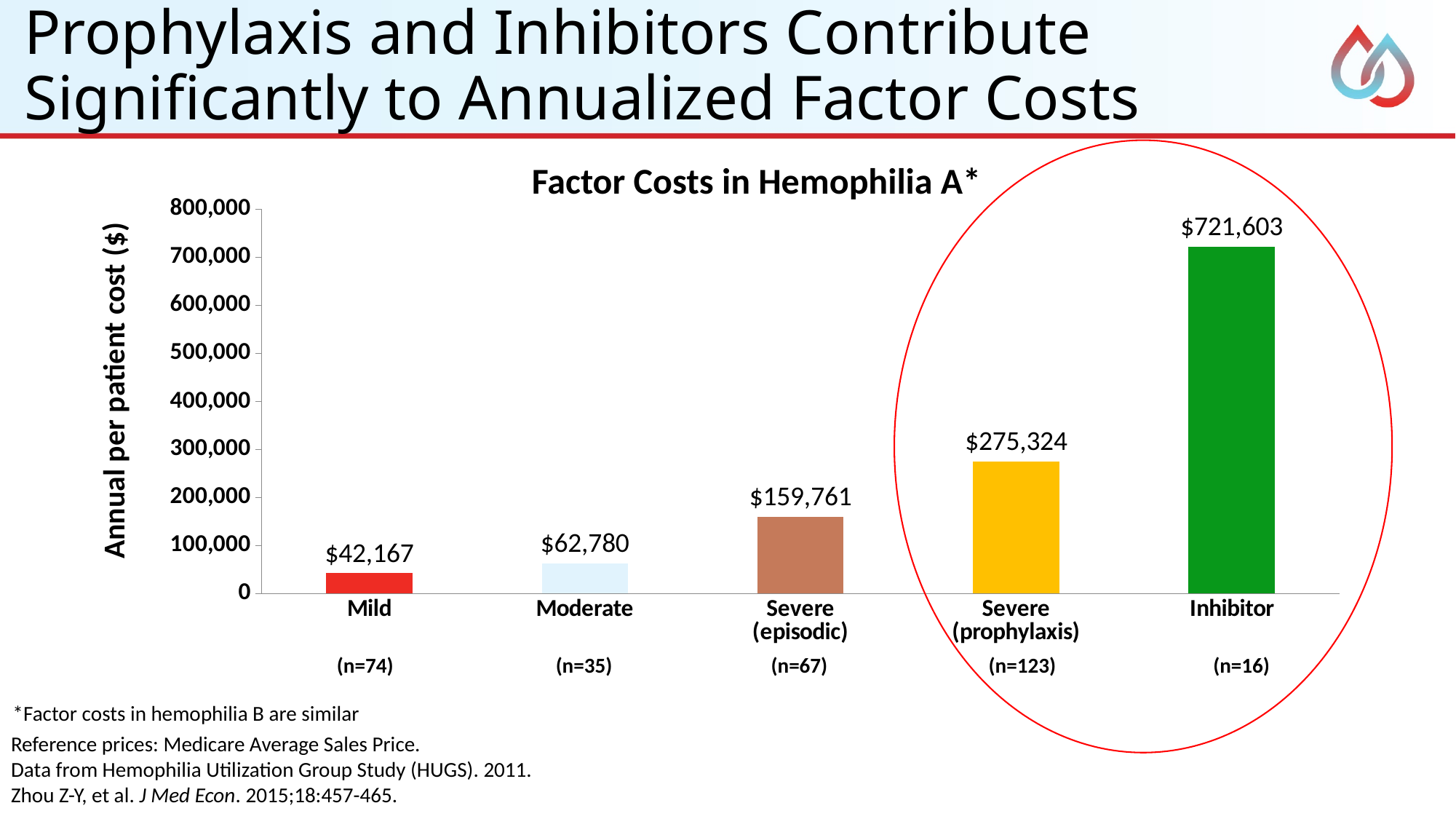
What is the annual per patient factor cost for Severe (prophylaxis)? $275,324 What type of chart is used to show factor costs in hemophilia A? Bar chart What is the annual per patient factor cost for the Inhibitor category? $721,603 What is the difference in annual per patient cost between Severe (prophylaxis) and Severe (episodic)? $115,563 Is the annual per patient cost for Inhibitor greater or less than 700,000? greater What is the title of the chart? Factor Costs in Hemophilia A* Which has a higher annual per patient cost, Moderate or Severe (episodic)? Severe (episodic) Do the annual per patient costs rise or fall moving from Mild to Inhibitor along the x axis? Rise What is the annual per patient factor cost for Mild hemophilia A? $42,167 Which category has the lowest annual per patient factor cost? Mild How many categories are shown on the x axis of the chart? 5 Which category has the highest annual per patient factor cost? Inhibitor